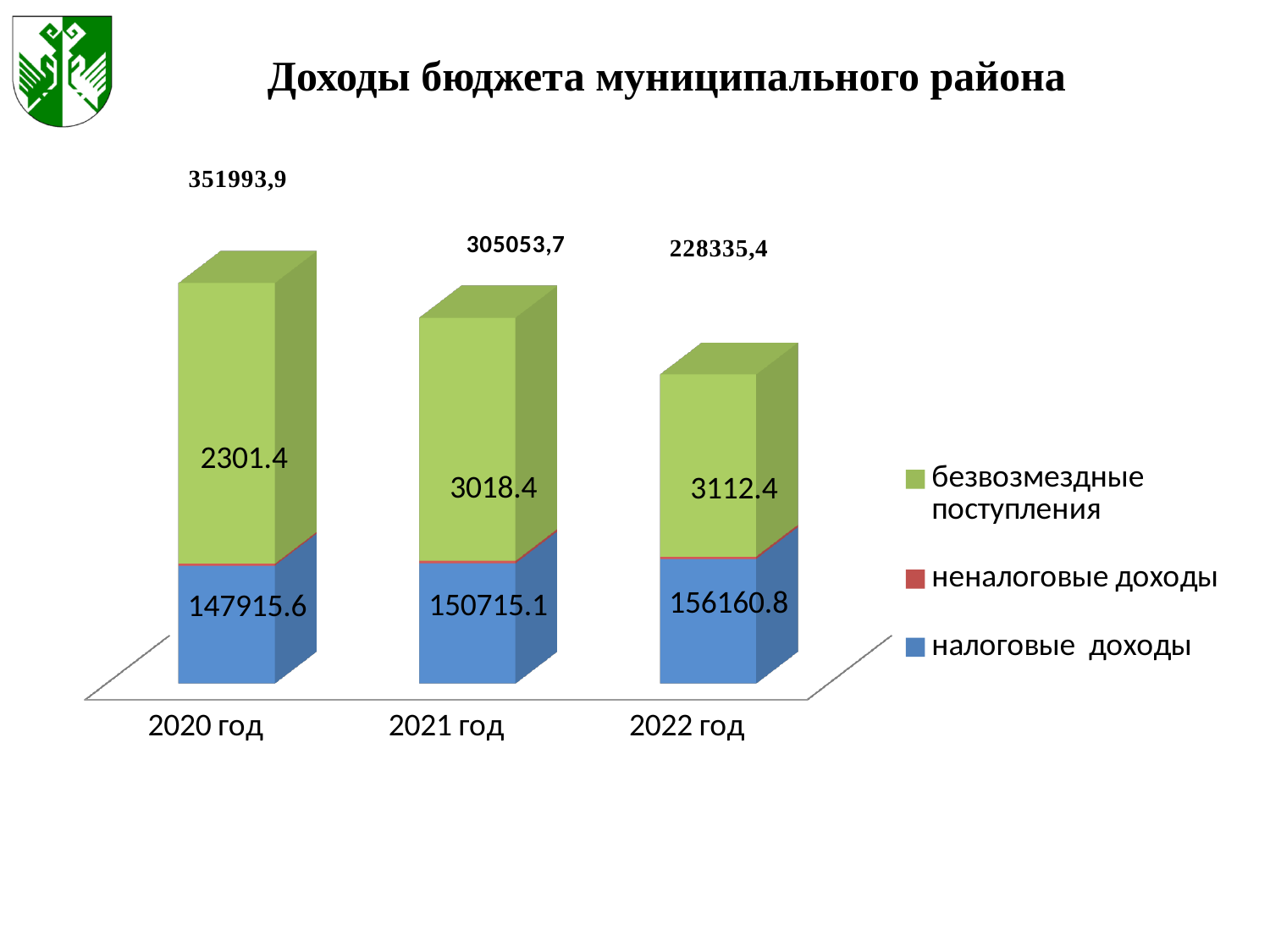
What total value is printed above the 2022 год bar? 228335,4 How many series does the legend list? 3 What is the difference in налоговые доходы between 2022 год and 2020 год? 8245.2 Do the totals printed above the bars rise or fall from 2020 год to 2022 год? Fall What total value is printed above the 2020 год bar? 351993,9 What is the value of налоговые доходы for 2020 год? 147915.6 How many years are shown on the x axis? 3 Which year has the lowest total printed above its bar? 2022 год Which year has the highest value of налоговые доходы? 2022 год Which year has the larger value of налоговые доходы, 2020 год or 2021 год? 2021 год What is the value of налоговые доходы for 2022 год? 156160.8 What kind of chart is shown on the slide? Stacked bar chart